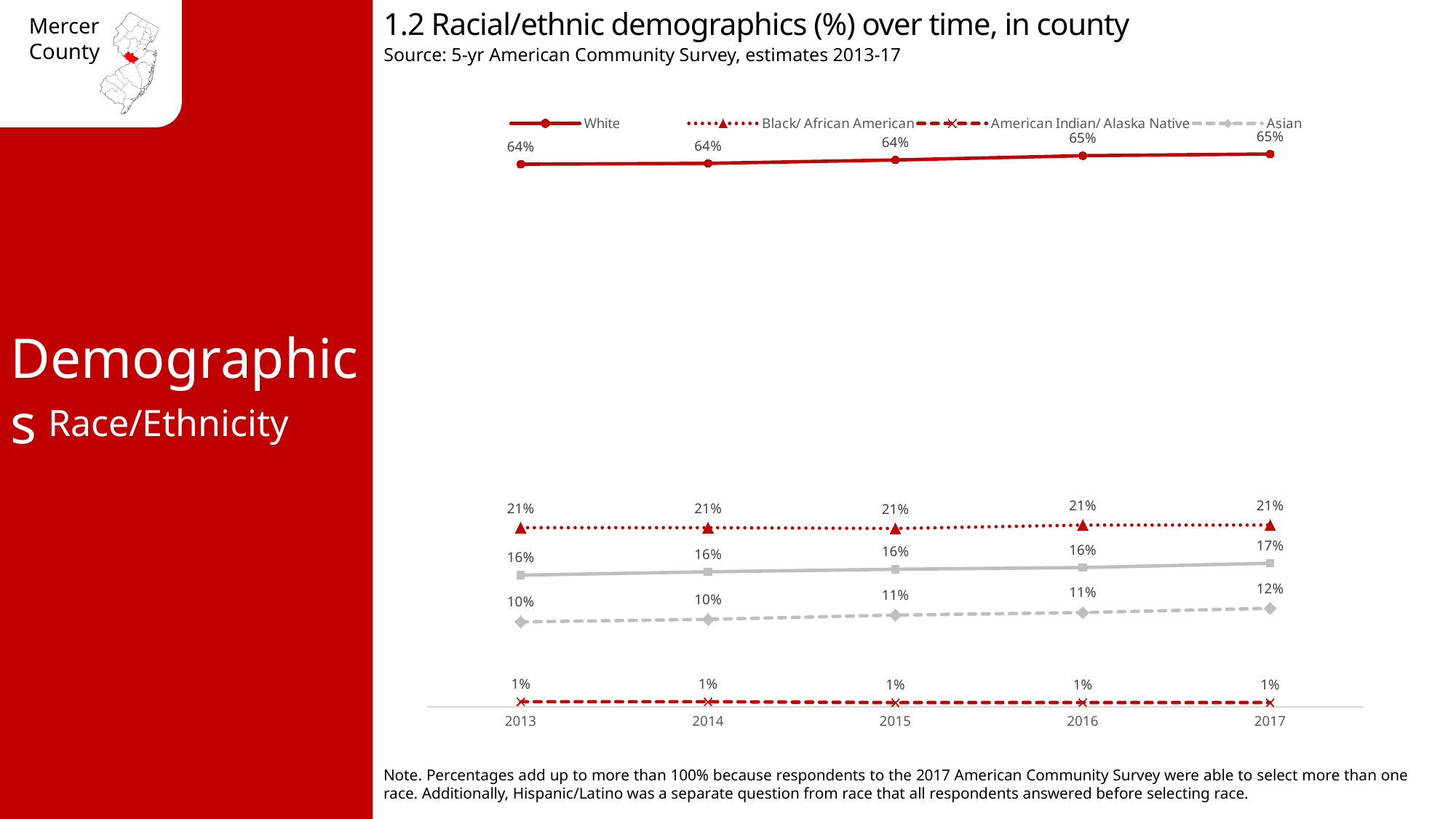
Which series has the lowest value in 2013? American Indian/ Alaska Native Which is larger in 2014, Black/ African American or Asian? Black/ African American By how much did the Asian value change from 2013 to 2017? 2% What is the value for Asian in 2013? 10% What is the value for Black/ African American in 2015? 21% Which series has the highest value in 2017? White What is the value for American Indian/ Alaska Native in 2016? 1% Does the Asian value rise or fall from 2013 to 2017? Rise What kind of chart is this? Line chart How many years are shown on the x axis? 5 What is the difference between the White and Black/ African American values in 2017? 44% What is the value for White in 2017? 65%